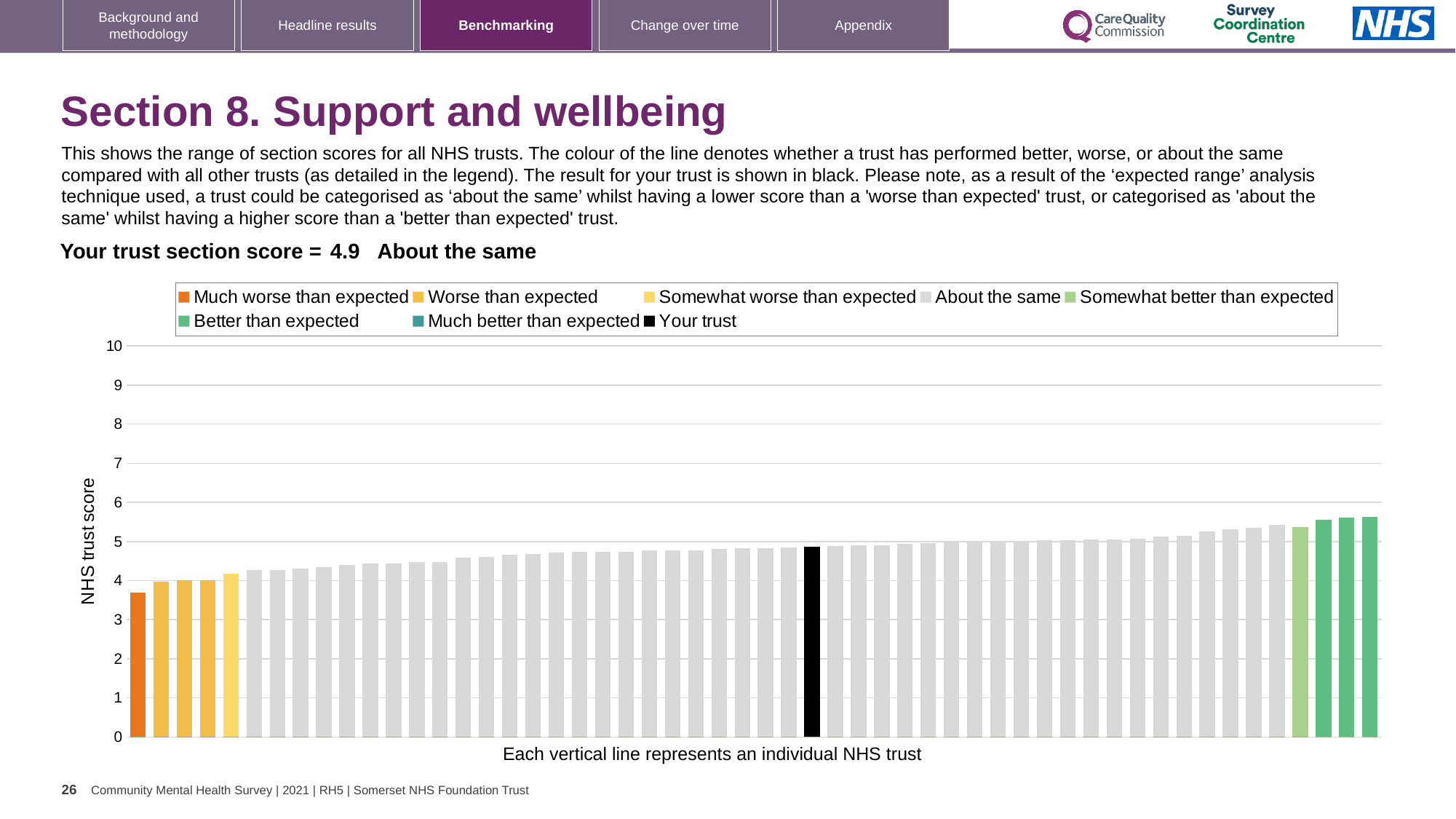
Is the value of the highest bar (the rightmost bar) greater or less than 5? greater What is the label of the y axis? NHS trust score What kind of chart is shown on the slide? bar chart Which legend category does the colour of the lowest bar correspond to? Much worse than expected How many bars are coloured as 'Much worse than expected' (orange)? 1 Is the value of the lowest bar (the leftmost, orange bar) greater or less than 4? less What is the section score for your trust shown on the slide? 4.9 How many bars are coloured as 'Better than expected' (dark green)? 3 How is your trust's section score categorised compared with other trusts? About the same Do the bar values rise or fall from left to right along the x axis? rise Is the value of the highest bar (the rightmost bar) greater or less than 6? less How many entries does the chart legend list? 8